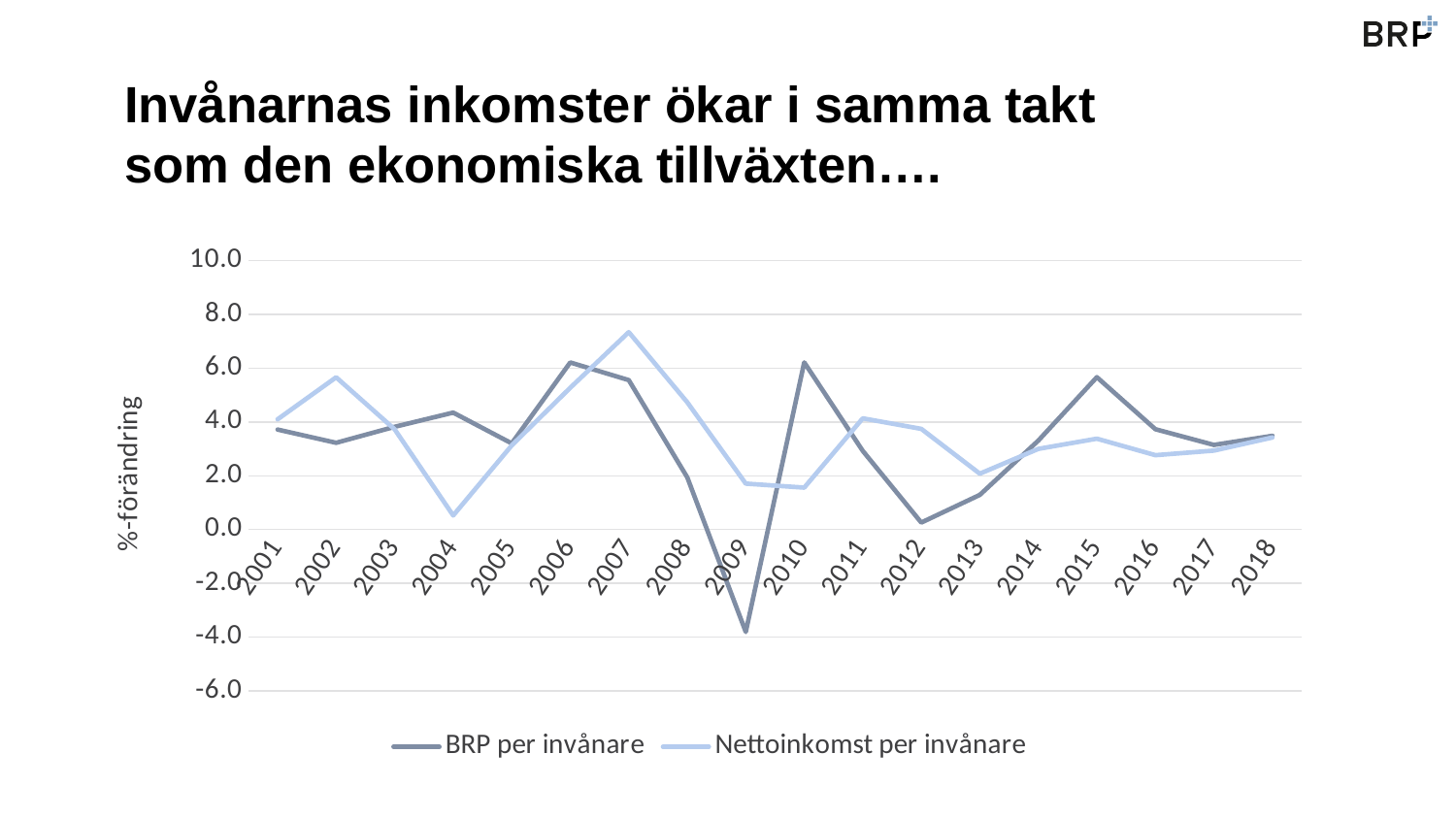
Is the value for Nettoinkomst per invånare in 2007 greater or less than 6.0? greater Is the value for BRP per invånare in 2012 greater or less than 2.0? less How many years are plotted along the x axis? 18 Is the value for BRP per invånare in 2009 greater or less than 0.0? less In which year is the value for Nettoinkomst per invånare lowest? 2004 How many series does the legend list? 2 In which year is the value for Nettoinkomst per invånare highest? 2007 What is the label on the vertical axis? %-förändring What kind of chart is shown on the slide? line chart In 2009, which series has the larger value, BRP per invånare or Nettoinkomst per invånare? Nettoinkomst per invånare In which year is the value for BRP per invånare lowest? 2009 In 2010, which series has the larger value, BRP per invånare or Nettoinkomst per invånare? BRP per invånare